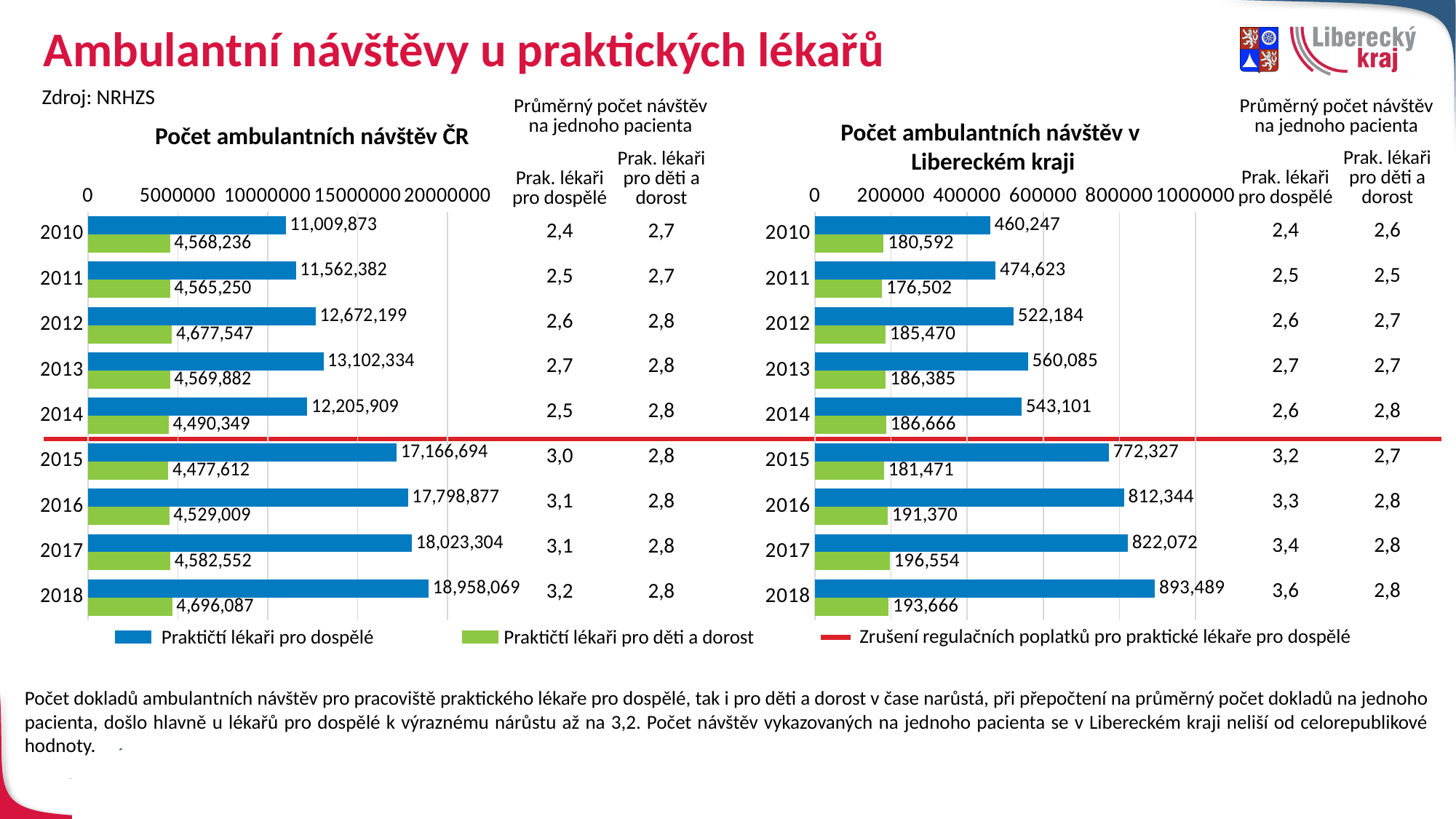
In the chart 'Počet ambulantních návštěv v Libereckém kraji', which year has the lowest value for Praktičtí lékaři pro dospělé? 2010 In the chart 'Počet ambulantních návštěv ČR', what is the value for Praktičtí lékaři pro dospělé in 2018? 18,958,069 In the chart 'Počet ambulantních návštěv ČR', is the value for Praktičtí lékaři pro dospělé in 2015 greater or less than 15000000? greater In the chart 'Počet ambulantních návštěv v Libereckém kraji', is the value for Praktičtí lékaři pro dospělé in 2014 greater or less than 600000? less In the chart 'Počet ambulantních návštěv ČR', which year has the highest value for Praktičtí lékaři pro dospělé? 2018 In the chart 'Počet ambulantních návštěv ČR', does the value for Praktičtí lékaři pro dospělé rise or fall from 2015 to 2018? Rise What type of chart is 'Počet ambulantních návštěv v Libereckém kraji'? Bar chart How many years are shown in the chart 'Počet ambulantních návštěv ČR'? 9 In the chart 'Počet ambulantních návštěv v Libereckém kraji', by how much did the value for Praktičtí lékaři pro dospělé increase from 2017 to 2018? 71,417 In the chart 'Počet ambulantních návštěv v Libereckém kraji', what is the value for Praktičtí lékaři pro děti a dorost in 2017? 196,554 In the chart 'Počet ambulantních návštěv v Libereckém kraji', which is larger for Praktičtí lékaři pro děti a dorost: 2016 or 2018? 2018 In the chart 'Počet ambulantních návštěv ČR', what is the difference between Praktičtí lékaři pro dospělé and Praktičtí lékaři pro děti a dorost in 2018? 14,261,982